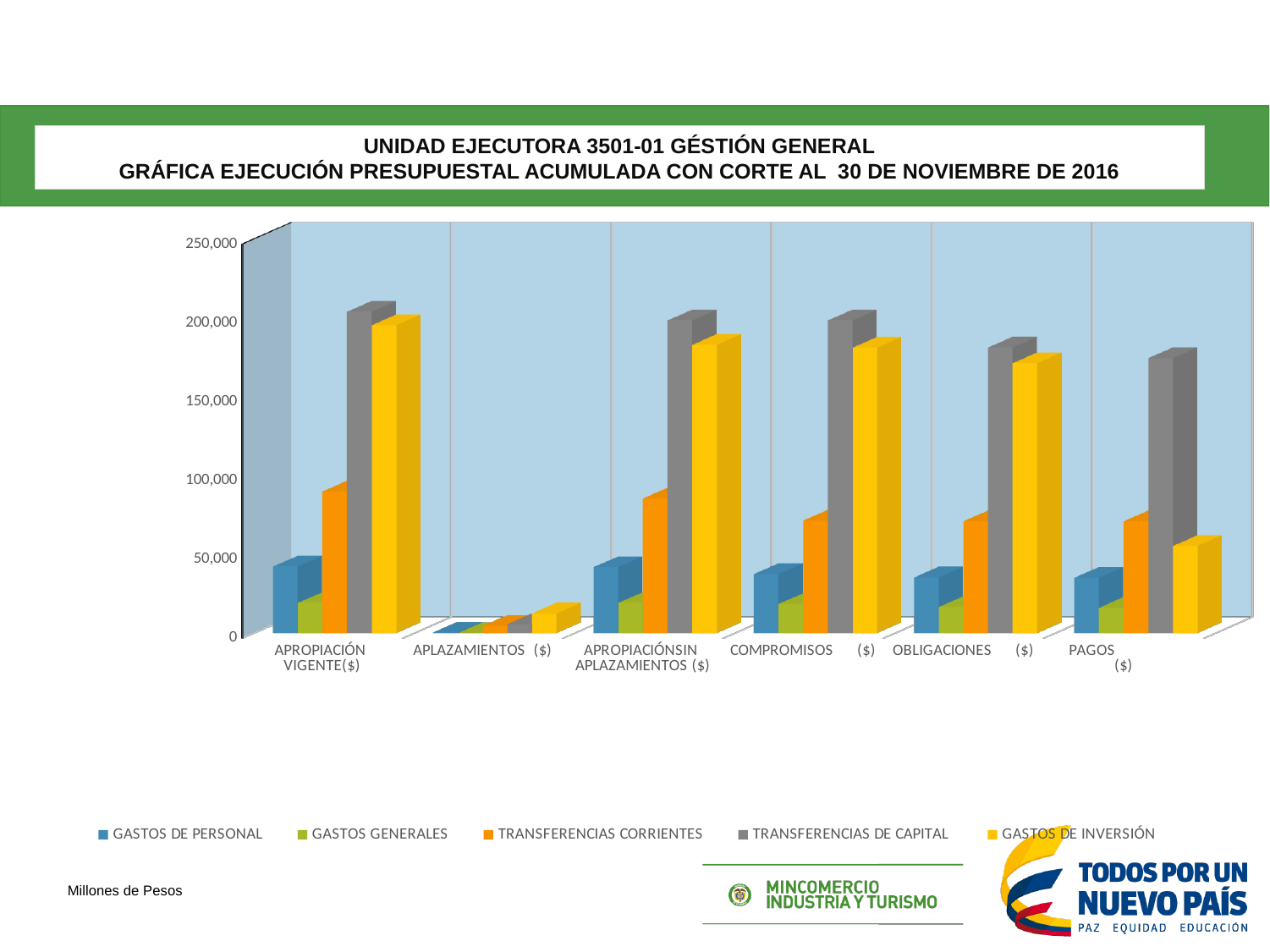
What kind of chart is shown on the slide? Bar chart How many series does the chart legend list? 5 What unit is stated below the chart for the values? Millones de Pesos How many categories are shown along the x axis of the chart? 6 Which category has the lowest values across all series? APLAZAMIENTOS ($) Is the value of TRANSFERENCIAS CORRIENTES for APROPIACIÓN VIGENTE($) greater or less than 50,000? greater In the COMPROMISOS ($) category, which is larger: GASTOS DE INVERSIÓN or TRANSFERENCIAS CORRIENTES? GASTOS DE INVERSIÓN Is the value of GASTOS DE PERSONAL for APROPIACIÓN VIGENTE($) greater or less than 100,000? less Is the value of TRANSFERENCIAS DE CAPITAL for APROPIACIÓN VIGENTE($) greater or less than 150,000? greater Does the value of GASTOS DE INVERSIÓN rise or fall from APROPIACIÓN SIN APLAZAMIENTOS ($) to PAGOS ($)? Fall Which series has the highest value in the PAGOS ($) category? TRANSFERENCIAS DE CAPITAL